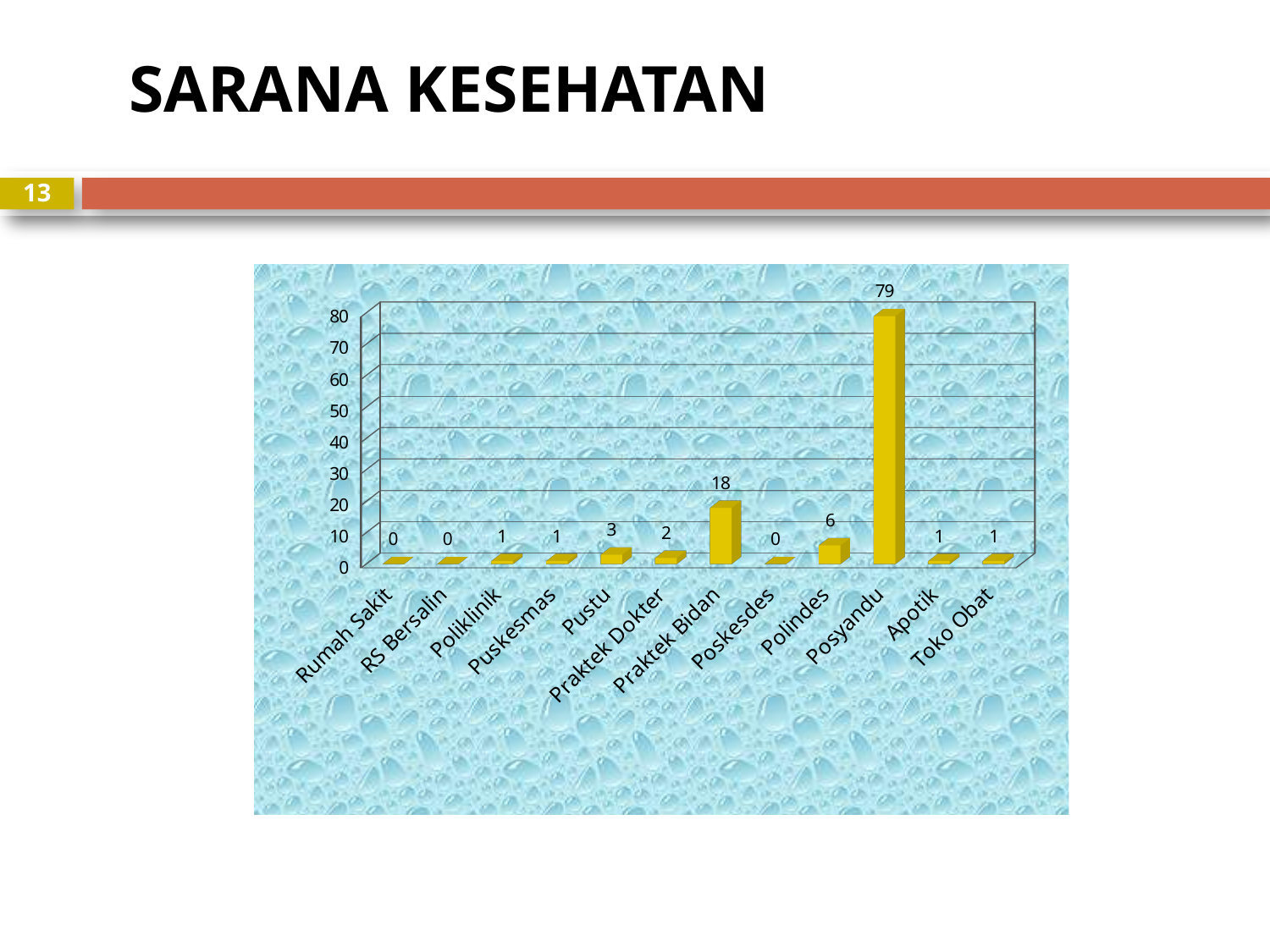
What is the title of the slide containing the chart? SARANA KESEHATAN What kind of chart is shown on the slide? Bar chart What is the value for Pustu? 3 What is the value for Polindes? 6 What is the value for Praktek Dokter? 2 How many categories are shown on the x axis? 12 What is the value for Posyandu? 79 Which category has the highest value? Posyandu What is the difference between the values for Posyandu and Praktek Bidan? 61 Which is larger, the value for Polindes or the value for Pustu? Polindes How many categories have a value of 0? 3 What is the value for Praktek Bidan? 18